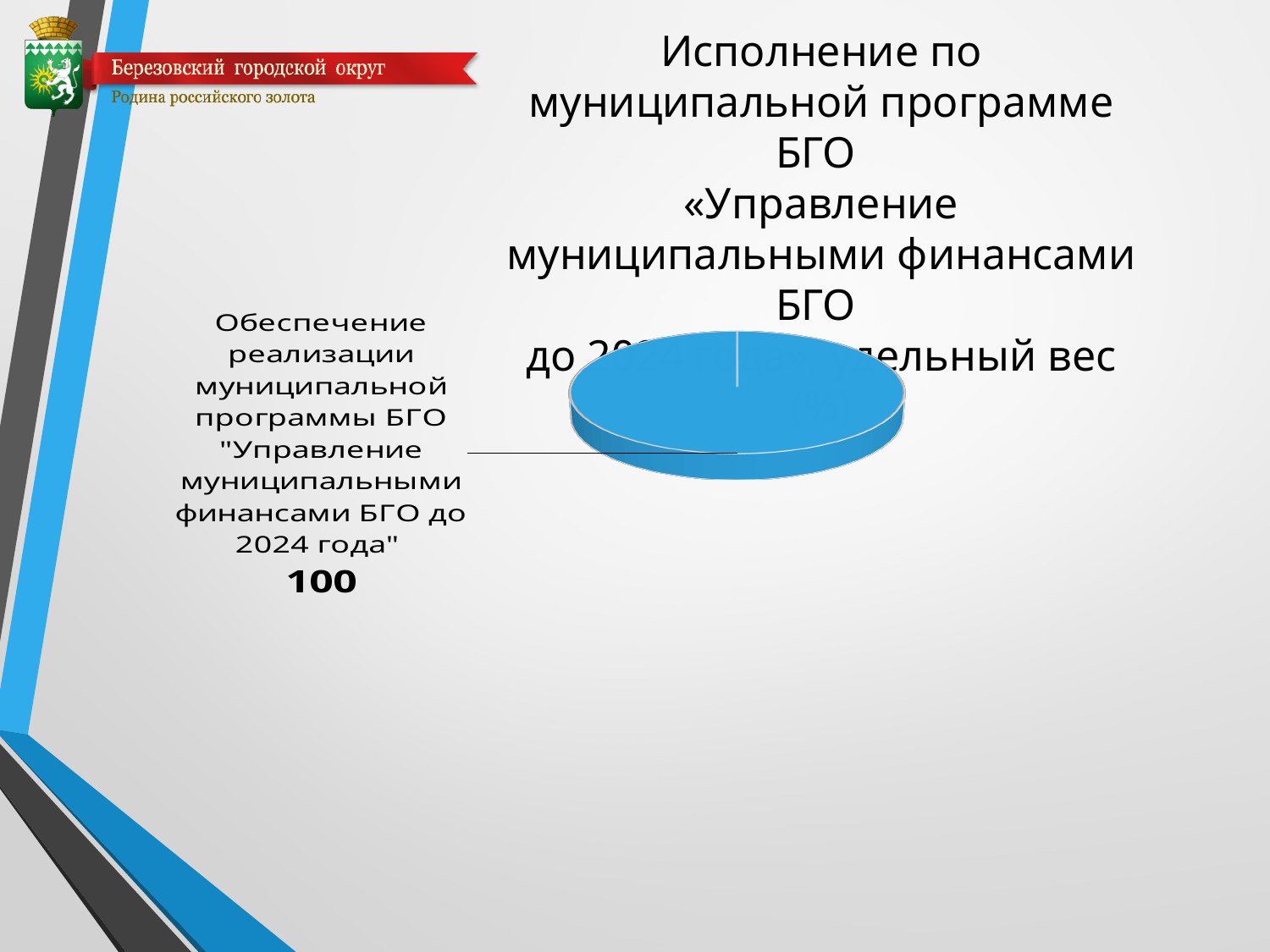
What share of the pie does the slice "Обеспечение реализации муниципальной программы БГО "Управление муниципальными финансами БГО до 2024 года"" take up? 100% What kind of chart is shown on the slide? pie chart What colour is the single slice of the pie chart? blue What value is shown for the slice "Обеспечение реализации муниципальной программы БГО "Управление муниципальными финансами БГО до 2024 года""? 100 Is the pie chart drawn in 3D or flat? 3D Is the value for the slice "Обеспечение реализации муниципальной программы БГО "Управление муниципальными финансами БГО до 2024 года"" greater or less than 50? greater How many slices does the pie chart have? 1